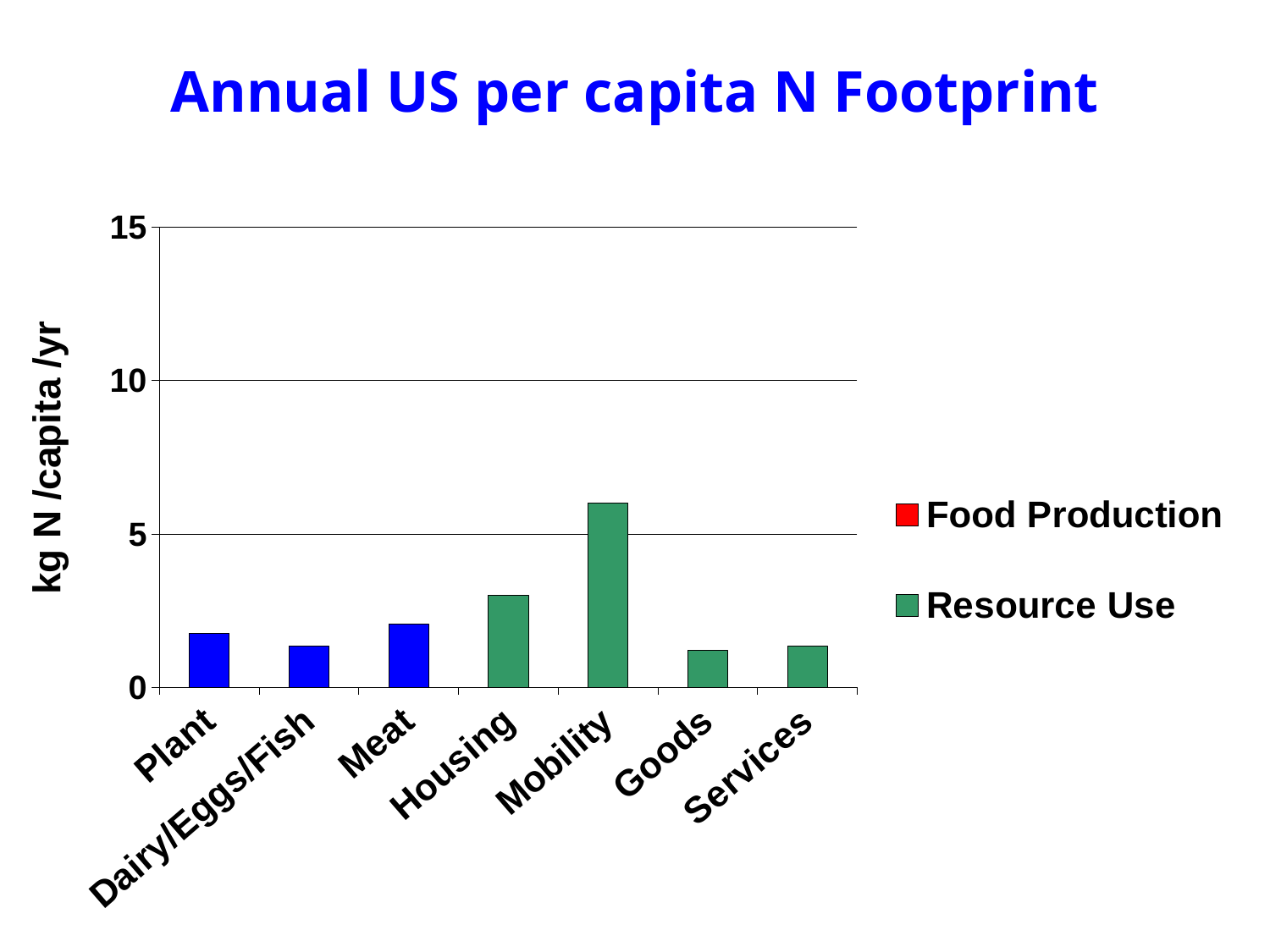
Is the value for Mobility greater or less than 5? greater Which is larger, the value for Housing or the value for Goods? Housing What is the title of the chart? Annual US per capita N Footprint Which is larger, the value for Mobility or the value for Housing? Mobility How many categories are shown on the x axis? 7 Which is larger, the value for Meat or the value for Dairy/Eggs/Fish? Meat Is the value for Mobility greater or less than 10? less What is the label on the y axis? kg N /capita /yr Which category has the highest value? Mobility What kind of chart is shown on the slide? bar chart Is the value for Housing greater or less than 5? less How many series does the legend list? 2